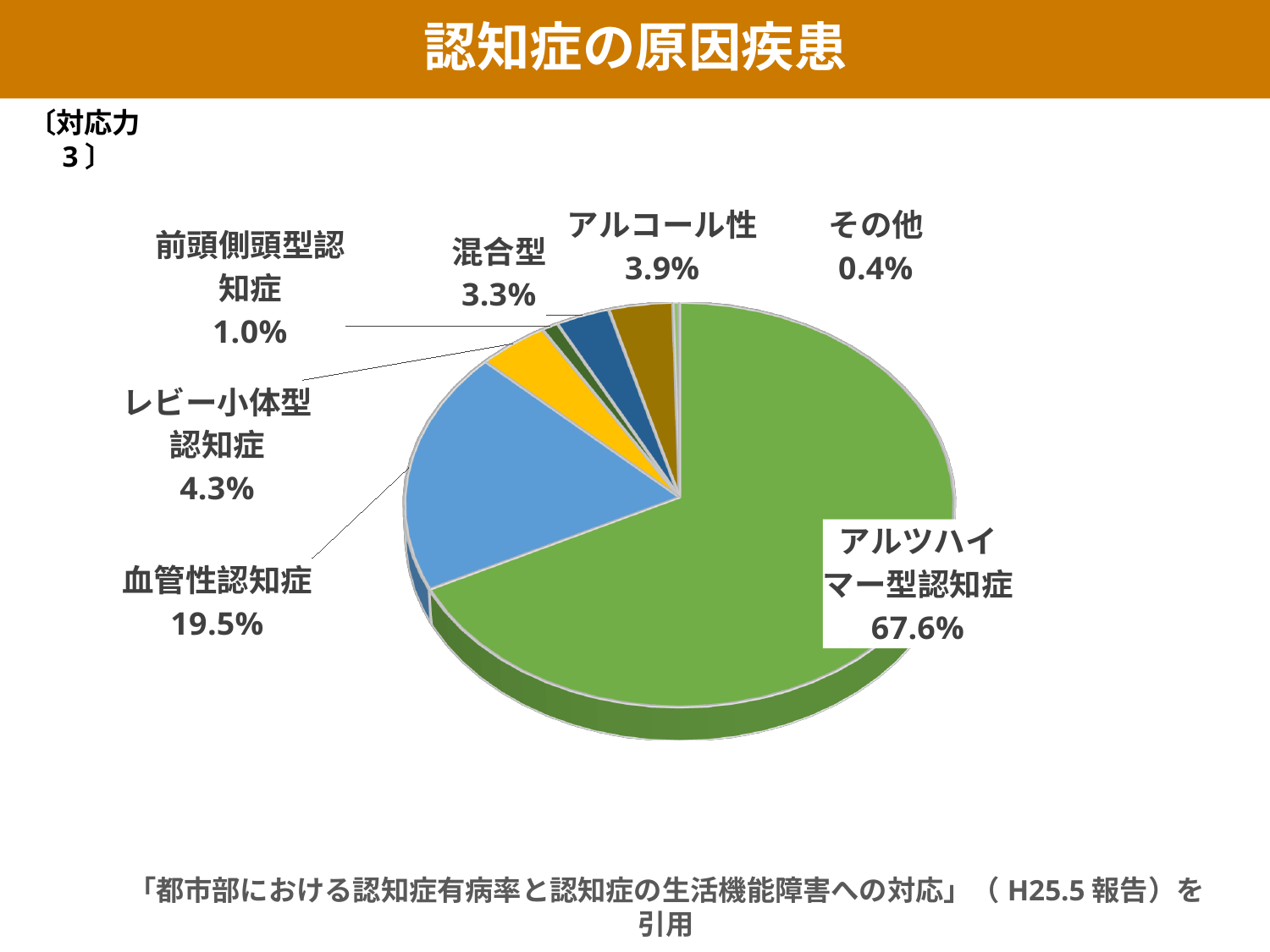
Which is larger, the value for レビー小体型認知症 or the value for アルコール性? レビー小体型認知症 What is the value shown for 混合型? 3.3% What kind of chart is shown on the slide? Pie chart Which category has the largest slice of the pie? アルツハイマー型認知症 What is the value shown for 血管性認知症? 19.5% What share of the pie does アルツハイマー型認知症 account for? 67.6% What is the value shown for レビー小体型認知症? 4.3% What is the difference between the values for アルツハイマー型認知症 and 血管性認知症? 48.1% How many categories are shown in the pie chart? 7 What is the value shown for アルコール性? 3.9% Which category has the smallest slice of the pie? その他 What is the title of the slide? 認知症の原因疾患